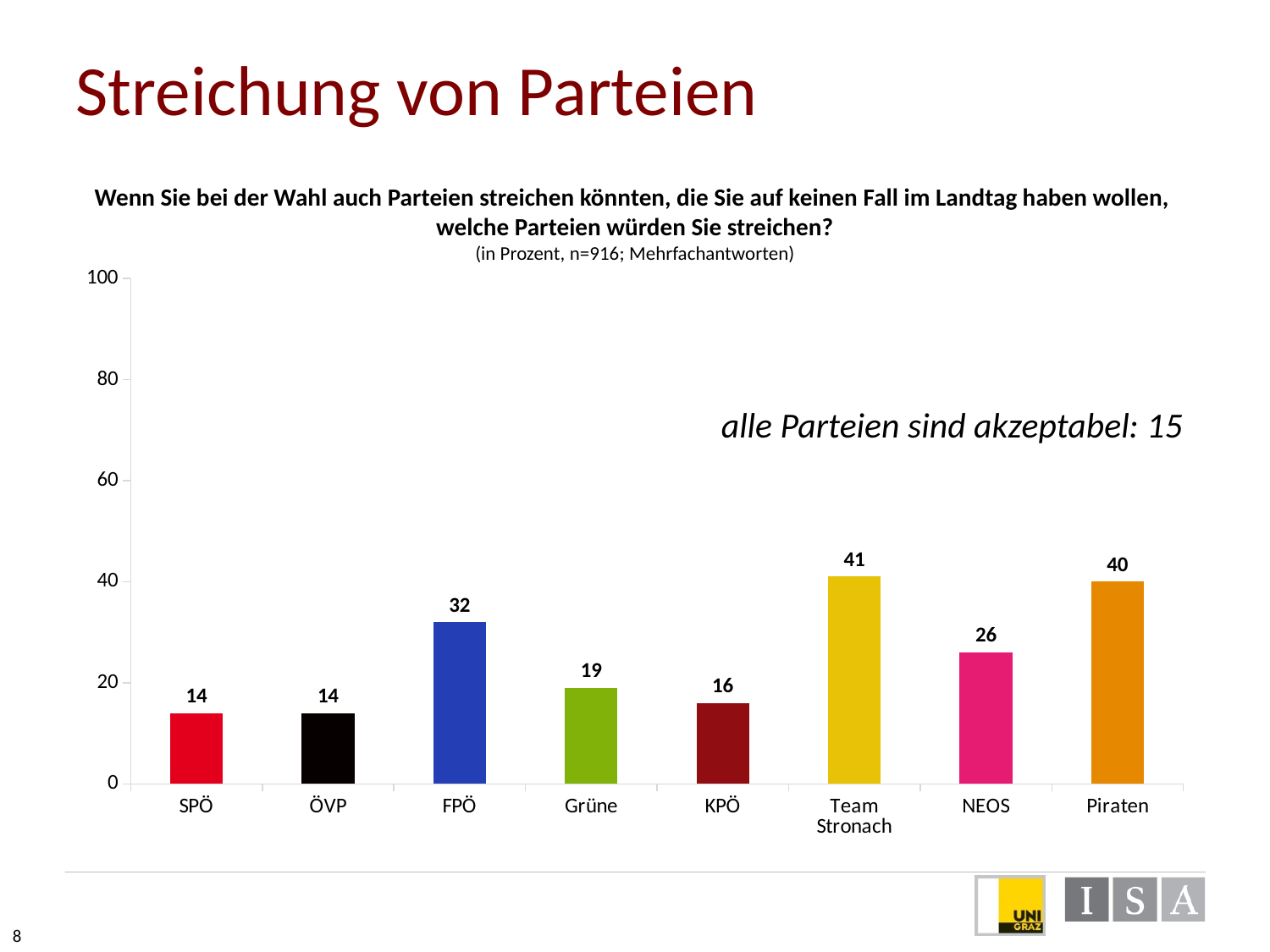
Which is larger, the value for FPÖ or the value for NEOS? FPÖ What kind of chart is shown? bar chart What is the sample size (n) stated in the chart subtitle? 916 Which parties share the lowest value? SPÖ and ÖVP Is the value for KPÖ greater or less than 20? less How many parties are shown on the x axis? 8 What is the value for Team Stronach? 41 What is the value for FPÖ? 32 What is the value given on the slide for 'alle Parteien sind akzeptabel'? 15 What is the value for NEOS? 26 Which party has the highest value? Team Stronach What is the difference between the values for Piraten and Grüne? 21